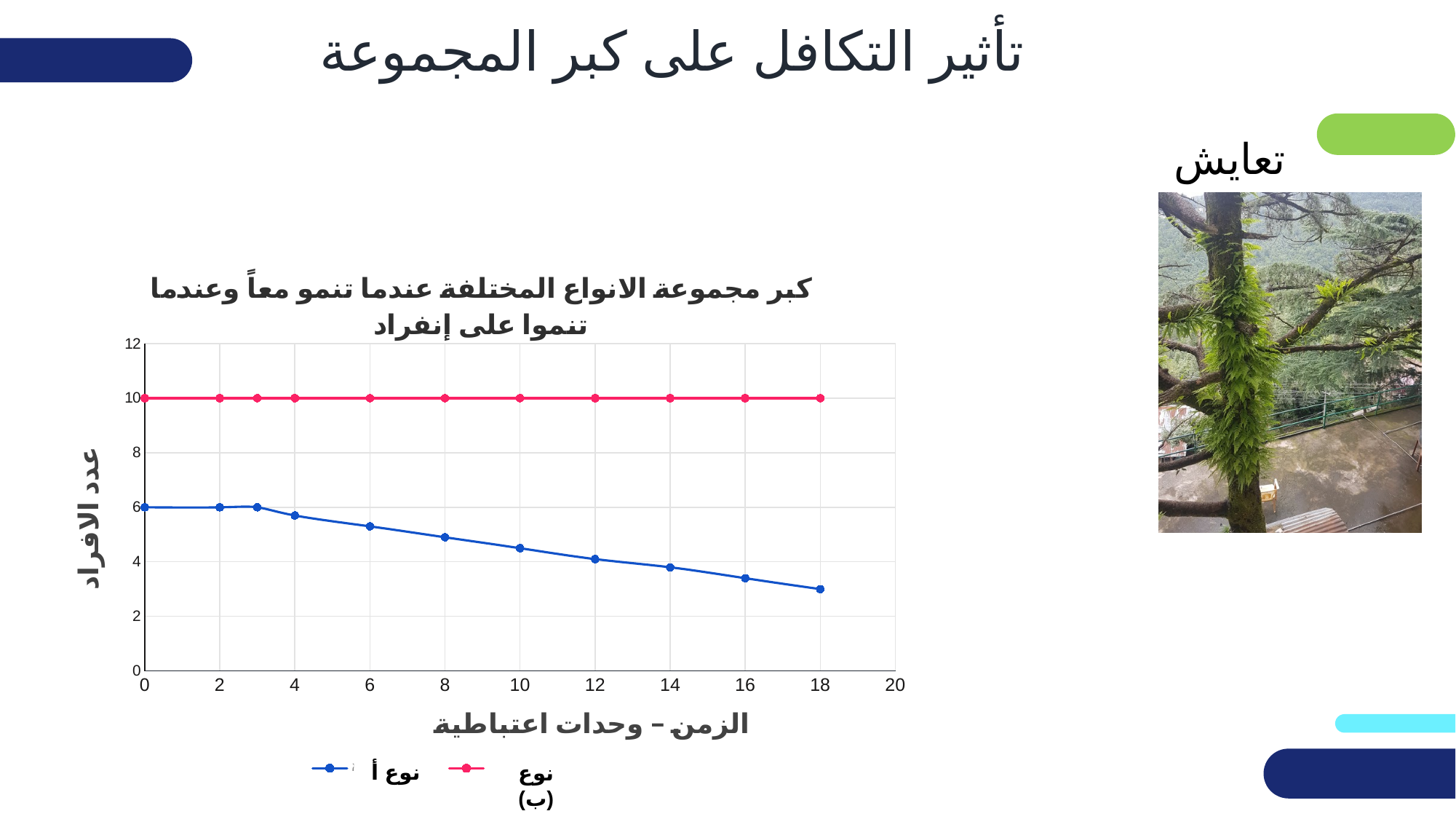
Does the نوع أ line rise or fall as time increases along the x axis? fall What is the label of the x axis of the chart? الزمن – وحدات اعتباطية Does the نوع (ب) line rise, fall or stay flat along the x axis? stay flat How many data points are plotted for the نوع أ series? 11 Is the value for نوع أ at time 18 greater or less than 4? less How many series does the chart legend list? 2 What is the value of نوع (ب) at time 10? 10 Is the value for نوع أ at time 6 greater or less than 4? greater At time 0, what is the difference between the value of نوع (ب) and the value of نوع أ? 4 What kind of chart is shown on the slide? line chart What is the value of نوع أ at time 0? 6 At time 18, which series has the higher value, نوع أ or نوع (ب)? نوع (ب)